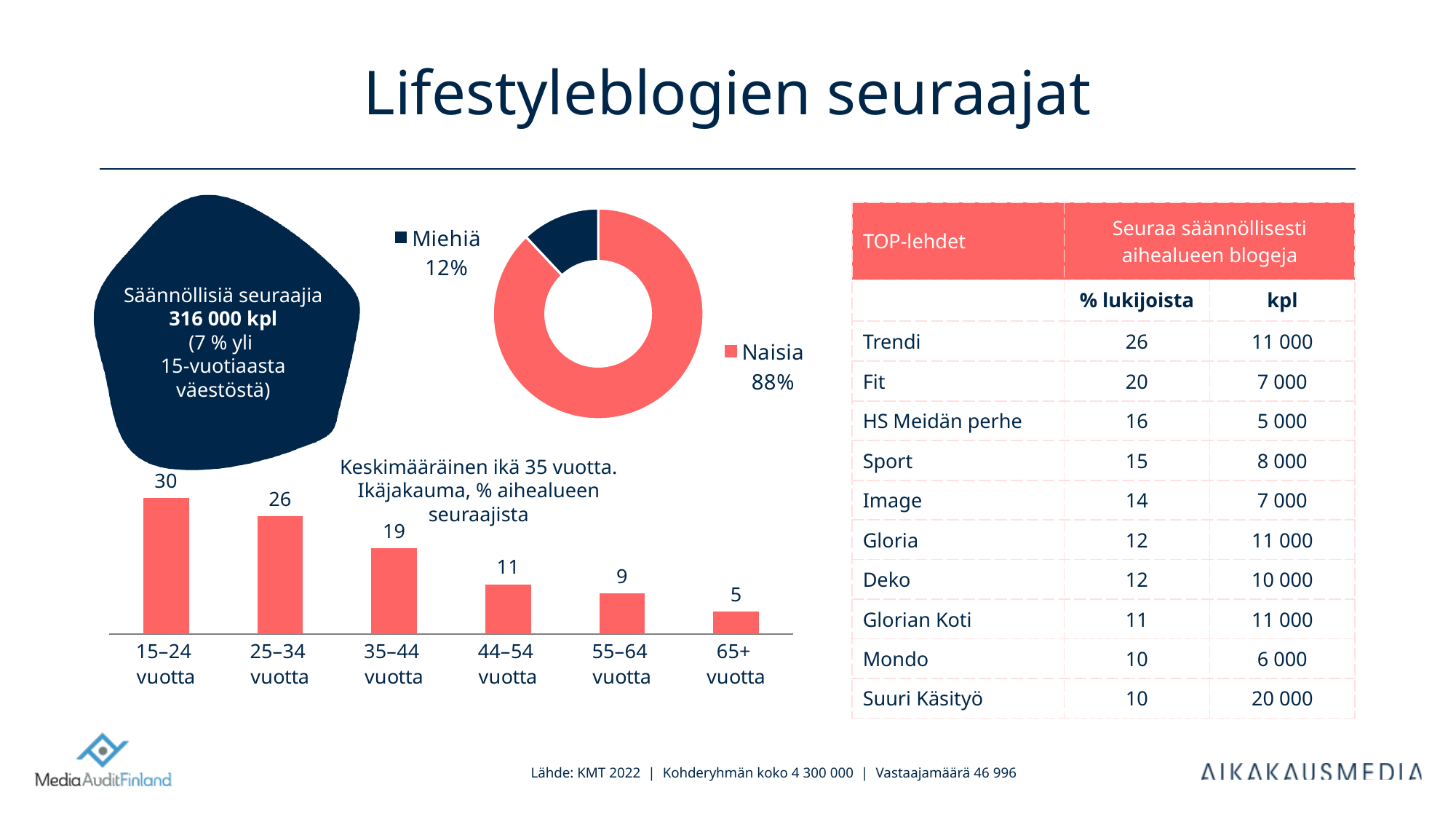
In the age distribution bar chart, do the values rise or fall as age increases along the x axis? fall In the donut chart, what share of lifestyle blog followers are men (Miehiä)? 12% How many categories does the donut chart show? 2 In the age distribution bar chart, what is the difference between the values for 25–34 vuotta and 55–64 vuotta? 17 In the age distribution bar chart, which age group has the highest value? 15–24 vuotta In the donut chart, which group is larger, Miehiä or Naisia? Naisia In the age distribution bar chart, what is the value for 15–24 vuotta? 30 In the age distribution bar chart, what is the value for 35–44 vuotta? 19 In the donut chart, what share of lifestyle blog followers are women (Naisia)? 88% What kind of chart is used to show the age distribution? bar chart In the age distribution bar chart, which age group has the lowest value? 65+ vuotta How many age groups are shown in the bar chart? 6